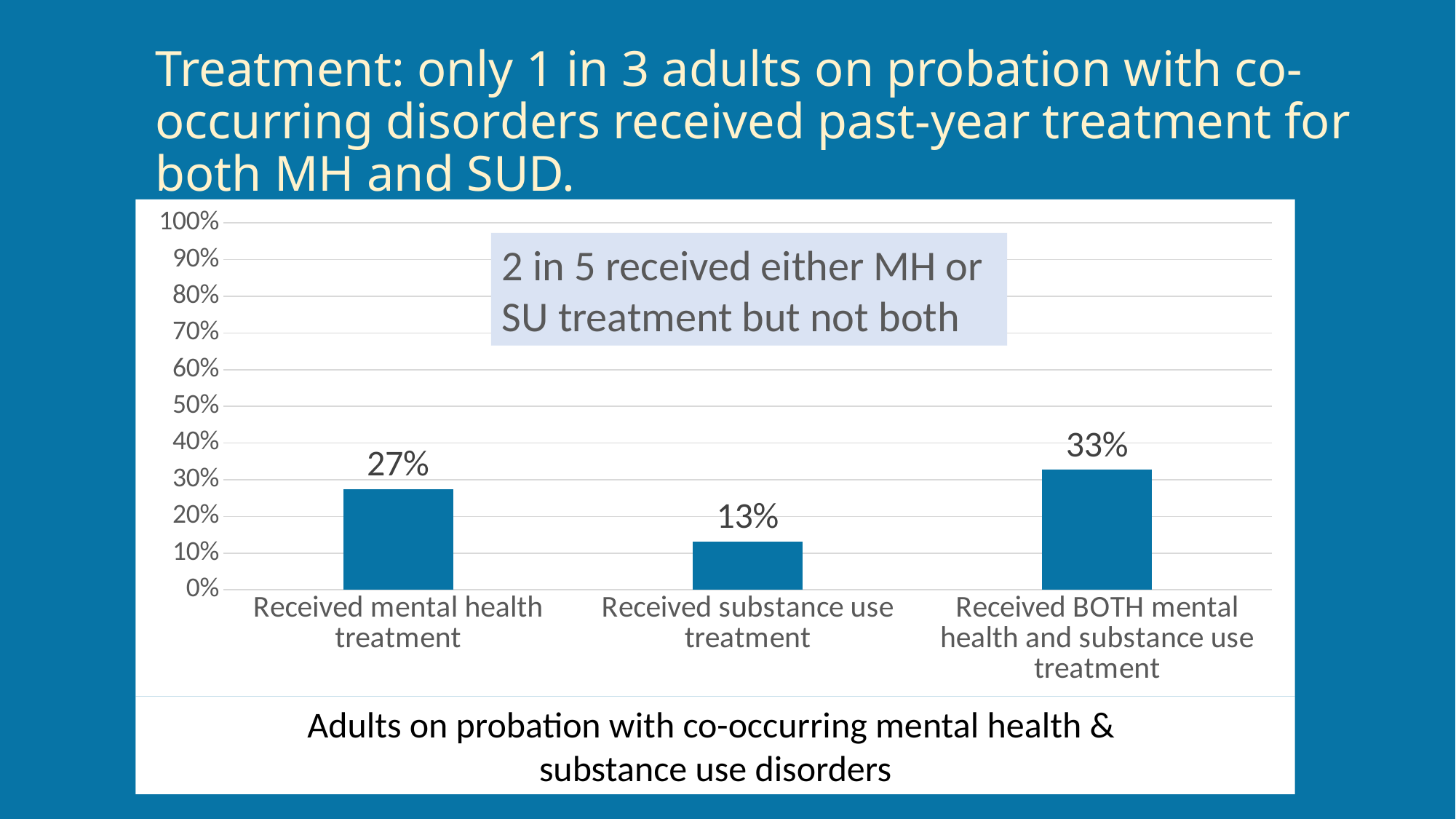
What is the difference between the percentage that received mental health treatment and the percentage that received substance use treatment? 14% What percentage received substance use treatment? 13% What is the title shown below the chart's x axis? Adults on probation with co-occurring mental health & substance use disorders How many categories are shown in the chart? 3 What percentage of adults on probation with co-occurring disorders received mental health treatment? 27% What percentage received BOTH mental health and substance use treatment? 33% What kind of chart is shown on the slide? Bar chart Which is larger: the value for received mental health treatment or the value for received substance use treatment? Received mental health treatment What is the difference between the percentage that received BOTH treatments and the percentage that received mental health treatment? 6% Which category has the lowest value? Received substance use treatment Is the value for received BOTH mental health and substance use treatment greater or less than 30%? greater Which category has the highest value? Received BOTH mental health and substance use treatment